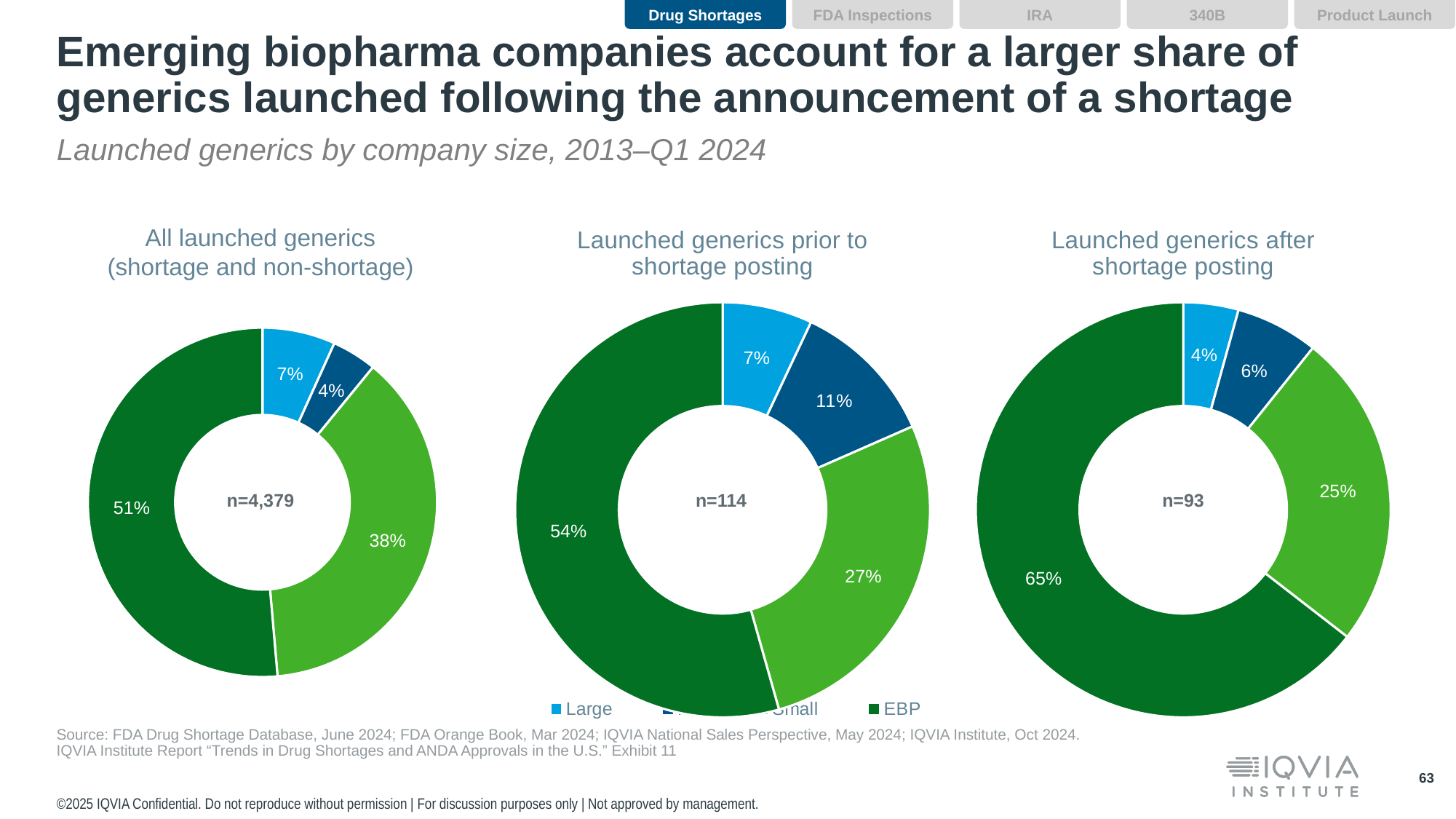
In the 'Launched generics after shortage posting' chart, what share is Large? 4% How many donut charts are shown on the slide? 3 Is the Small share larger in the 'All launched generics (shortage and non-shortage)' chart or in the 'Launched generics after shortage posting' chart? All launched generics (shortage and non-shortage) What is the sample size (n) shown in the centre of the 'All launched generics (shortage and non-shortage)' chart? n=4,379 What type of chart is used for the 'Launched generics prior to shortage posting' chart? Donut (pie) chart In the 'Launched generics prior to shortage posting' chart, which category has the largest share? EBP In the 'Launched generics after shortage posting' chart, what share is EBP? 65% In the 'All launched generics (shortage and non-shortage)' chart, what share is EBP? 51% What is the difference between the EBP share in the 'Launched generics after shortage posting' chart and the EBP share in the 'Launched generics prior to shortage posting' chart? 11 percentage points In the 'Launched generics prior to shortage posting' chart, what share is Small? 27% What is the sample size (n) shown in the centre of the 'Launched generics after shortage posting' chart? n=93